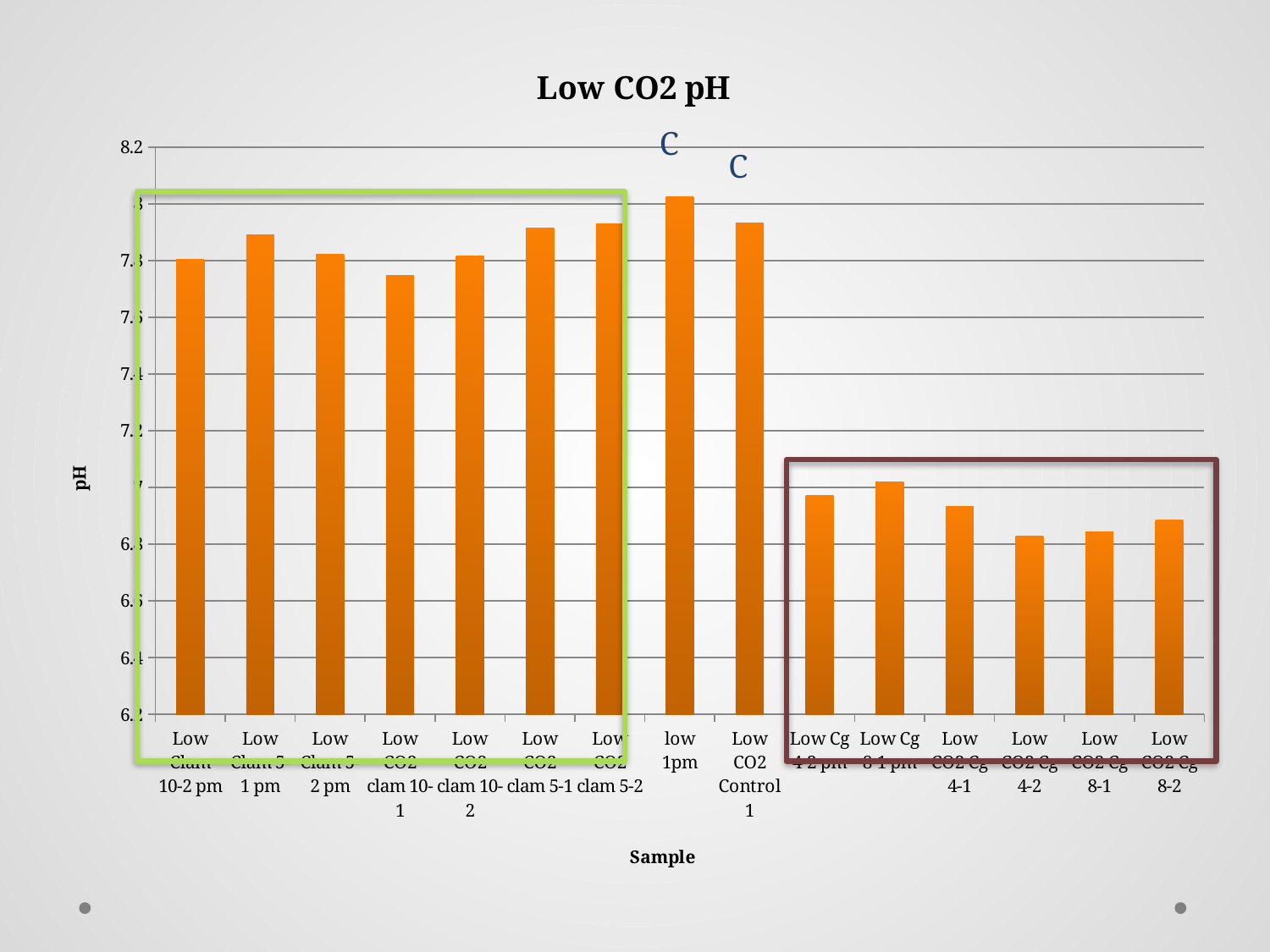
Which has the higher pH: low 1pm or Low CO2 Control 1? low 1pm How many bars (samples) are plotted in the chart? 15 Is the value for Low Clam 5 1 pm greater or less than 7.8? greater Which has the higher pH: Low CO2 clam 5-2 or Low CO2 clam 10-1? Low CO2 clam 5-2 What is the title of the chart? Low CO2 pH What is the label on the vertical axis of the chart? pH Which has the higher pH: Low Clam 10-2 pm or Low Cg 4 2 pm? Low Clam 10-2 pm Which sample has the highest pH in the chart? low 1pm Is the value for Low CO2 Control 1 greater or less than 8? less What kind of chart is shown on the slide? bar chart Is the value for Low CO2 Cg 4-1 greater or less than 7? less